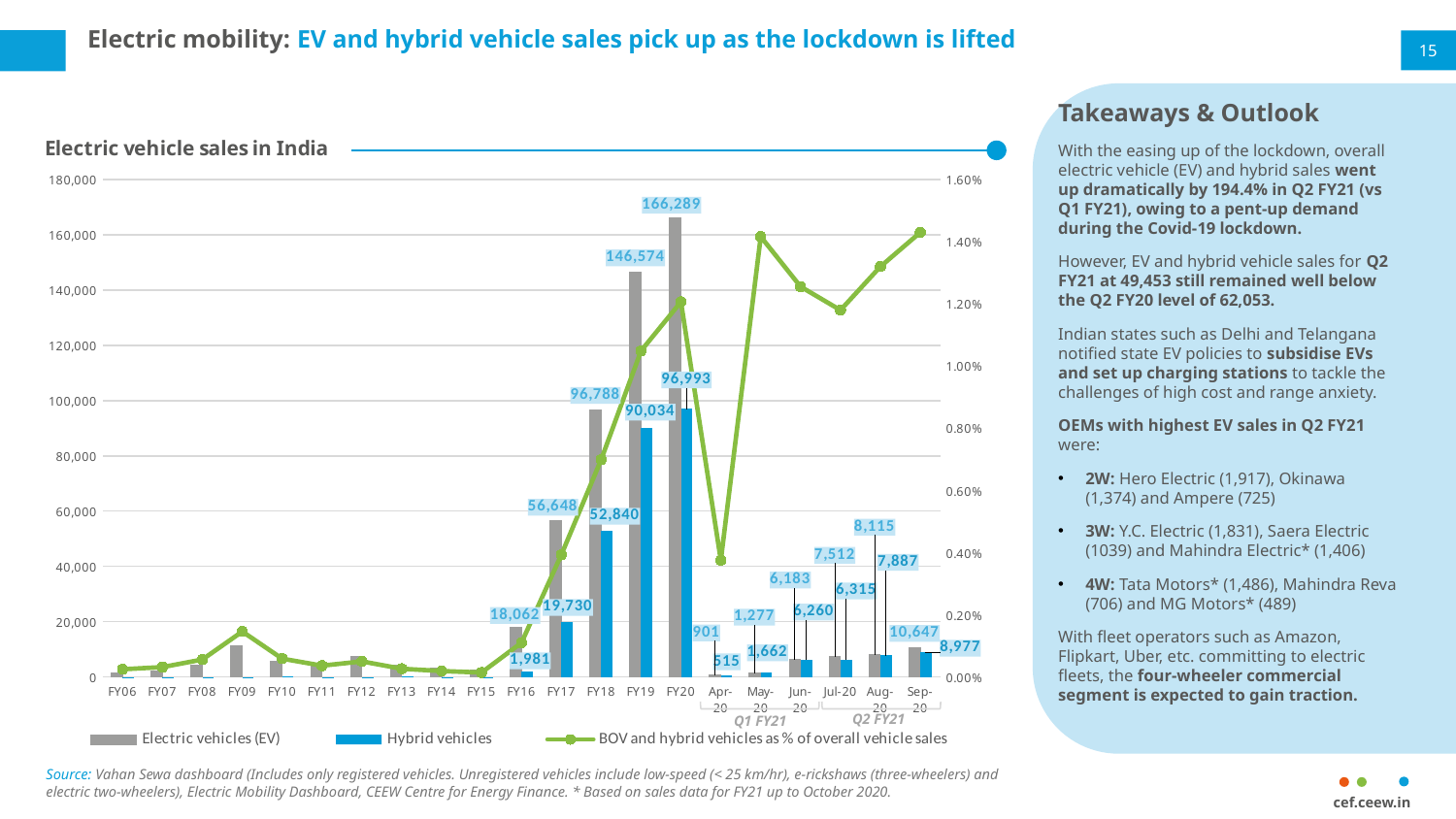
What were electric vehicle (EV) sales in FY20? 166,289 Which is larger: electric vehicle (EV) sales in FY18 or in FY19? FY19 How many series does the chart legend list? 3 What kind of chart is shown on the slide? Combination bar and line chart How many categories are shown along the x axis of the chart? 21 What were electric vehicle (EV) sales in Sep-20? 10,647 What were hybrid vehicle sales in FY19? 90,034 Do electric vehicle (EV) sales rise or fall from FY16 to FY20? rise Is the value of BOV and hybrid vehicles as % of overall vehicle sales in FY20 greater or less than 1.00%? greater What is the title of the chart? Electric vehicle sales in India Which period has the highest electric vehicle (EV) sales? FY20 What is the difference between electric vehicle (EV) sales and hybrid vehicle sales in FY20? 69,296